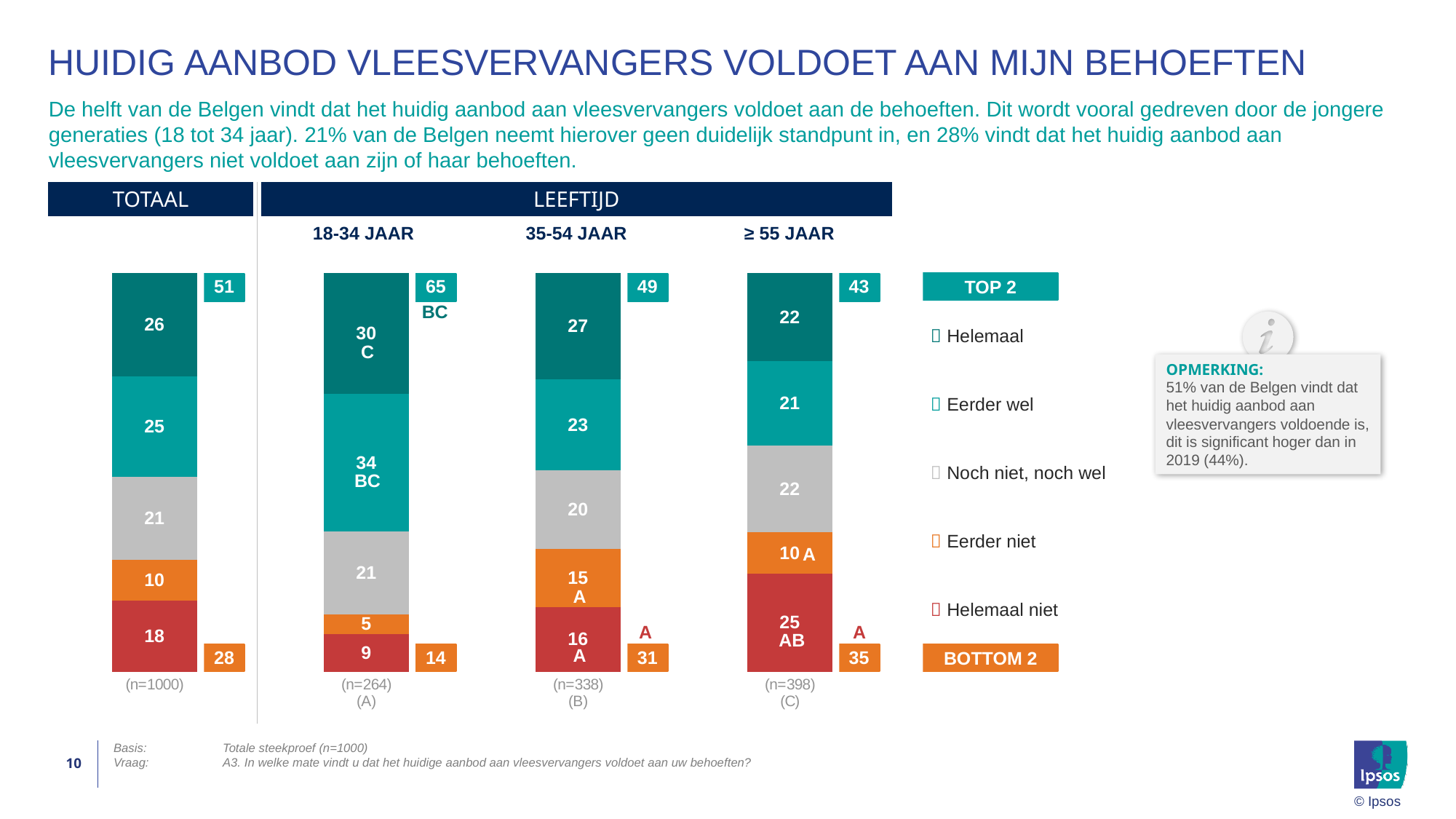
How many bars (groups) are shown on the slide? 4 What is the BOTTOM 2 value for the 18-34 JAAR group? 14 What is the TOP 2 value for the TOTAAL bar? 51 What is the difference between the TOP 2 value for 18-34 JAAR and the TOP 2 value for ≥ 55 JAAR? 22 What is the 'Helemaal' value for the 35-54 JAAR group? 27 Which age group has the highest TOP 2 value? 18-34 JAAR Which age group has the lowest BOTTOM 2 value? 18-34 JAAR What is the sample size (n) for the 35-54 JAAR group? n=338 How many response categories does the legend list? 5 What is the 'Noch niet, noch wel' value for the ≥ 55 JAAR group? 22 What type of chart is used to show the responses on this slide? Stacked bar chart Which is larger: the 'Helemaal niet' value for 35-54 JAAR or for ≥ 55 JAAR? ≥ 55 JAAR